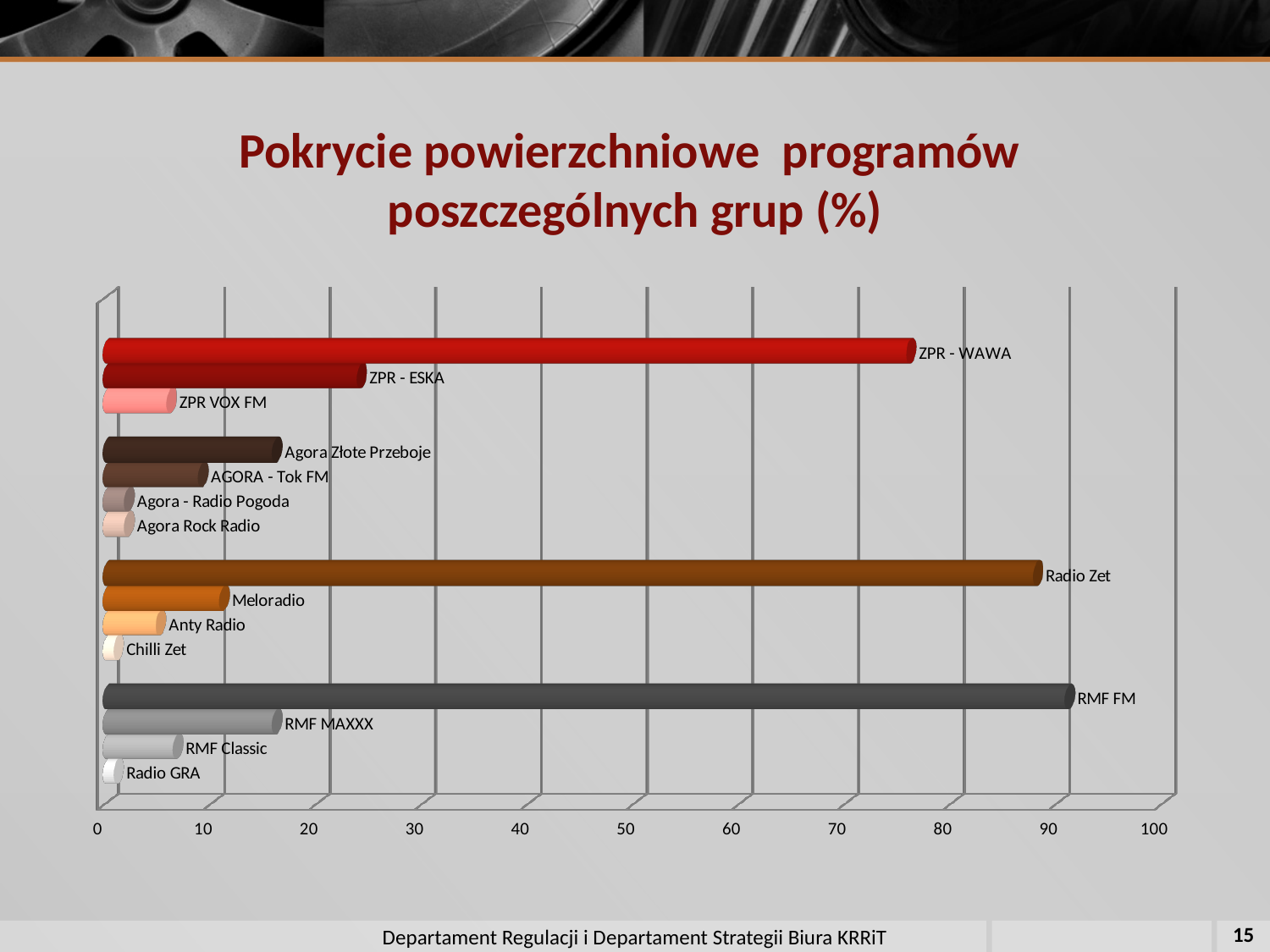
Is the value for ZPR VOX FM greater or less than 10? less How many radio programmes (bars) are plotted in the chart? 15 Which has the larger value, ZPR - WAWA or ZPR - ESKA? ZPR - WAWA Is the value for Radio Zet greater or less than 80? greater What kind of chart is shown on the slide? bar chart Is the value for ZPR - WAWA greater or less than 70? greater Which radio programme has the highest coverage in the chart? RMF FM Which has the larger value, Meloradio or Anty Radio? Meloradio What is the title of the chart on the slide? Pokrycie powierzchniowe programów poszczególnych grup (%)